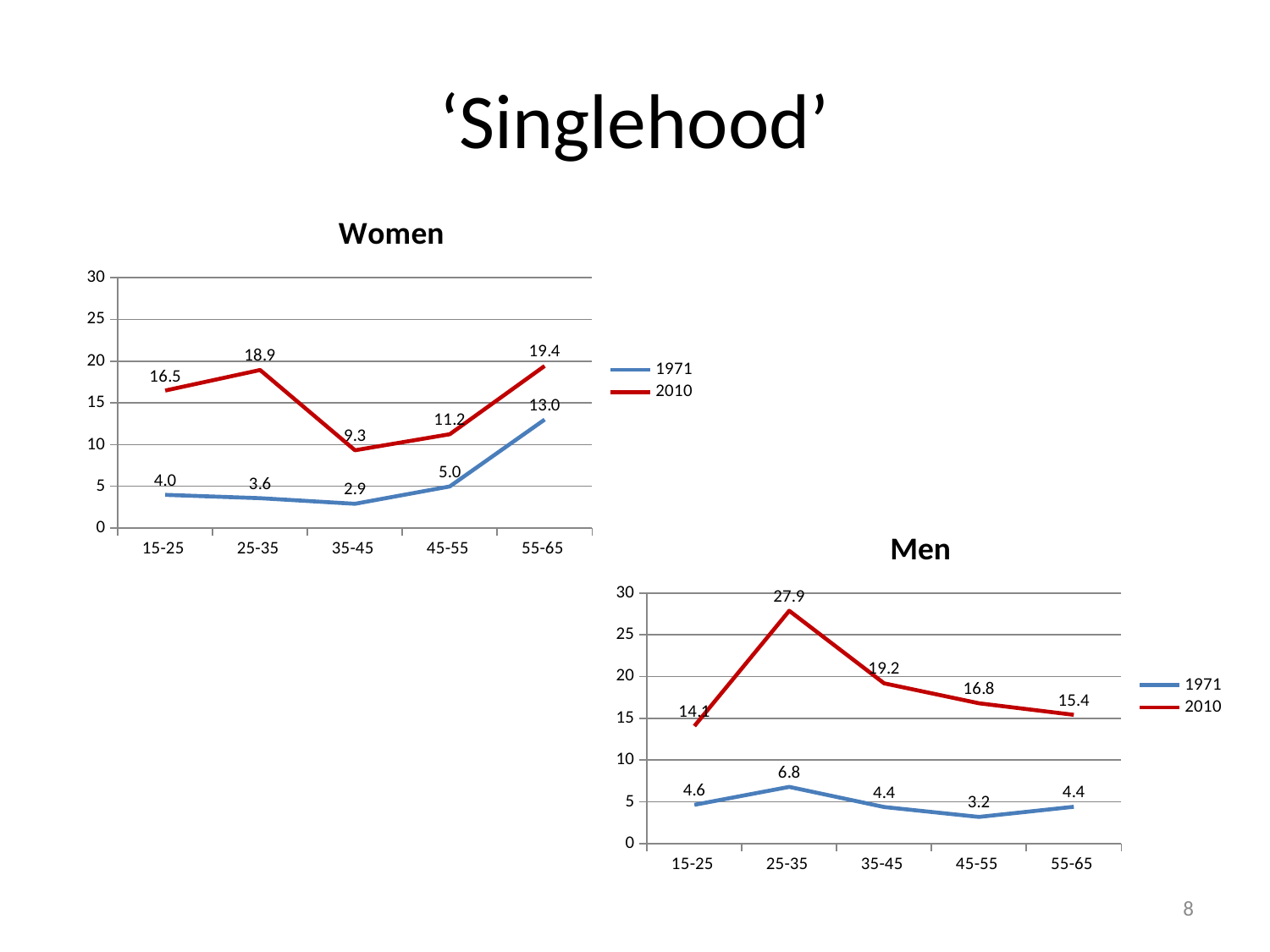
In the Women chart, what is the difference between the 2010 and 1971 values for the 15-25 age group? 12.5 In the Men chart, what is the 1971 value for the 45-55 age group? 3.2 How many series does the legend of the Men chart list? 2 In the Women chart, what is the 2010 value for the 25-35 age group? 18.9 How many age groups are shown on the x axis of the Women chart? 5 In the Men chart, what is the difference between the 2010 values for 25-35 and 55-65? 12.5 In the Women chart, what is the 1971 value for the 35-45 age group? 2.9 In the Men chart, which age group has the lowest 1971 value? 45-55 In the Women chart, which age group has the highest 2010 value? 55-65 In the Men chart, what is the 2010 value for the 25-35 age group? 27.9 In the Men chart, which is larger: the 1971 value for 15-25 or the 1971 value for 25-35? 25-35 What kind of chart is the Women chart? Line chart